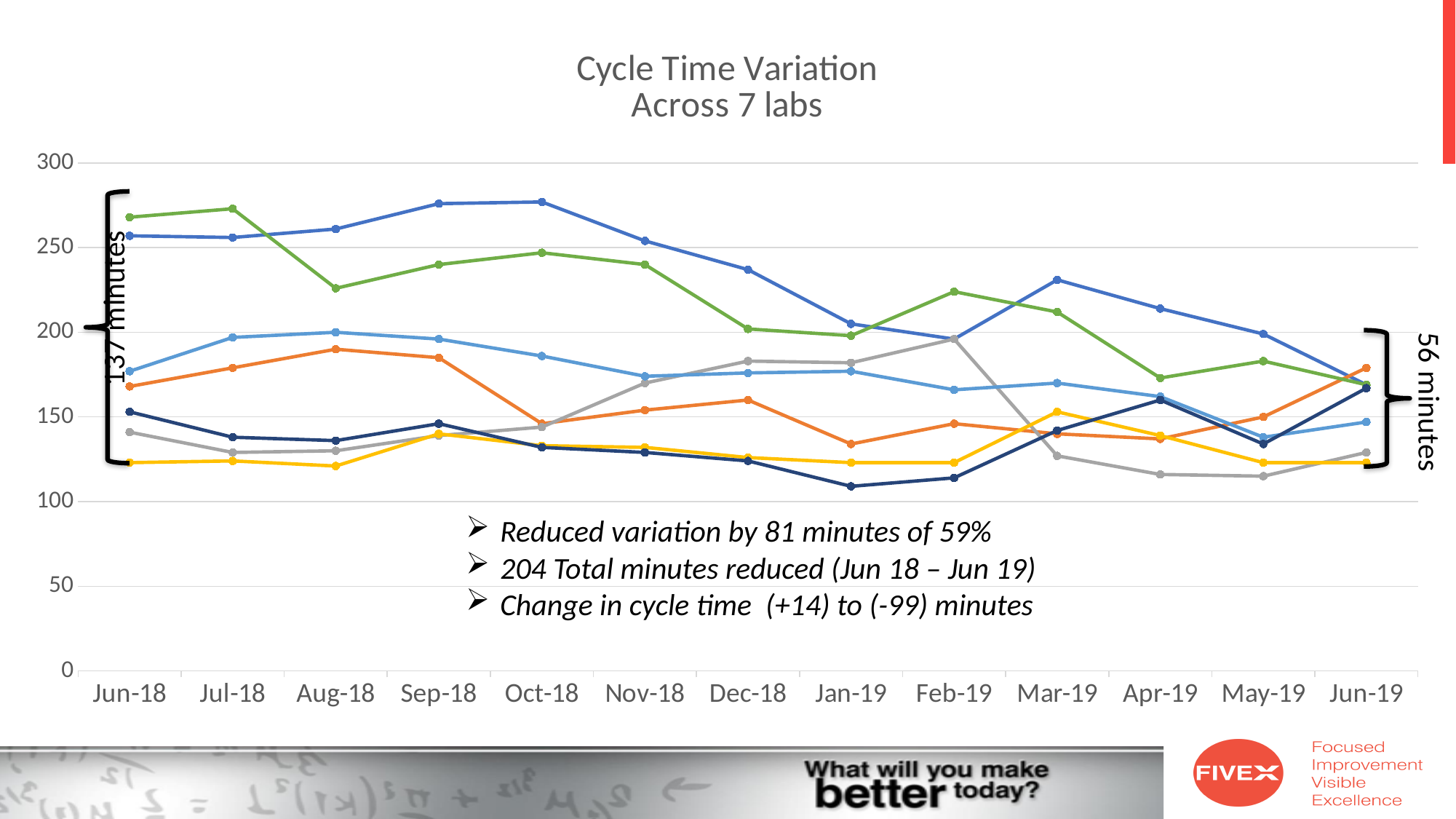
Is the value of the dark blue line in Jan-19 greater or less than 150? less According to the annotation, what was the spread in cycle time across the labs in Jun-19? 56 minutes What is the title of the chart? Cycle Time Variation Across 7 labs By how many minutes was the variation reduced between Jun-18 and Jun-19, according to the slide? 81 minutes What kind of chart is shown on the slide? line chart Is the value of the green line in Jun-18 greater or less than 250? greater Does the green line generally rise or fall from Jun-18 to Jun-19? fall According to the annotation, what was the spread in cycle time across the labs in Jun-18? 137 minutes How many months are shown along the x axis of the chart? 13 How many lines (labs) are plotted on the chart? 7 What is the first month shown on the x axis? Jun-18 Is the value of the yellow line in Jun-18 greater or less than 150? less